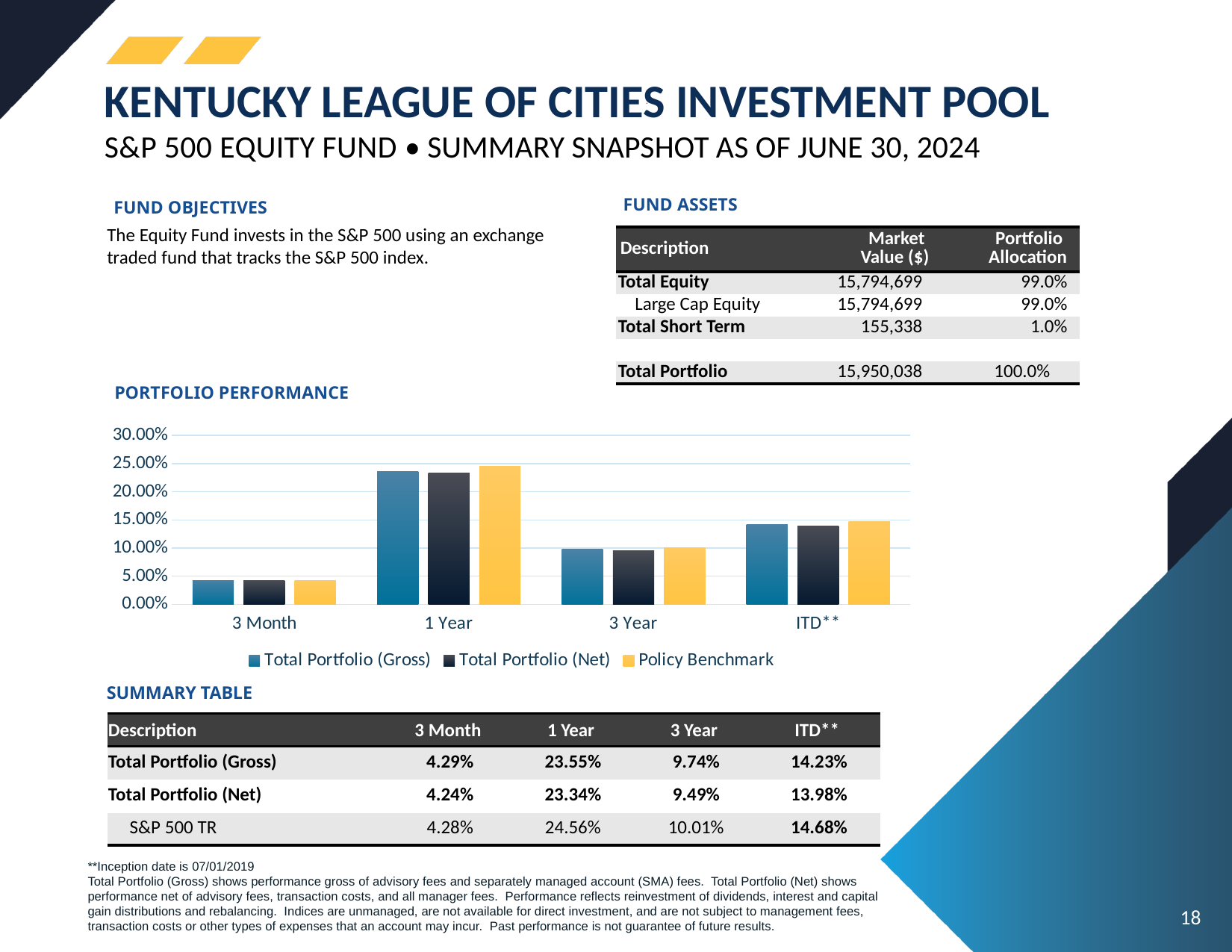
In the Portfolio Performance chart, is the Total Portfolio (Net) value for 3 Month greater or less than 5.00%? less In the Portfolio Performance chart, which is larger for Total Portfolio (Gross): 1 Year or ITD**? 1 Year What kind of chart is shown under Portfolio Performance? bar chart How many series does the legend of the Portfolio Performance chart list? 3 In the Portfolio Performance chart, which category has the lowest Policy Benchmark value? 3 Month In the Portfolio Performance chart, is the Policy Benchmark value for 3 Year greater or less than 15.00%? less In the Portfolio Performance chart, is the Total Portfolio (Gross) value for 1 Year greater or less than 20.00%? greater How many categories are shown on the x axis of the Portfolio Performance chart? 4 According to the summary table, what is the Total Portfolio (Gross) value for 1 Year plotted in the Portfolio Performance chart? 23.55% In the Portfolio Performance chart, which category has the highest Total Portfolio (Gross) value? 1 Year What are the three legend entries of the Portfolio Performance chart? Total Portfolio (Gross), Total Portfolio (Net), Policy Benchmark Using the summary table values, what is the difference between Total Portfolio (Gross) and Total Portfolio (Net) for 1 Year? 0.21%